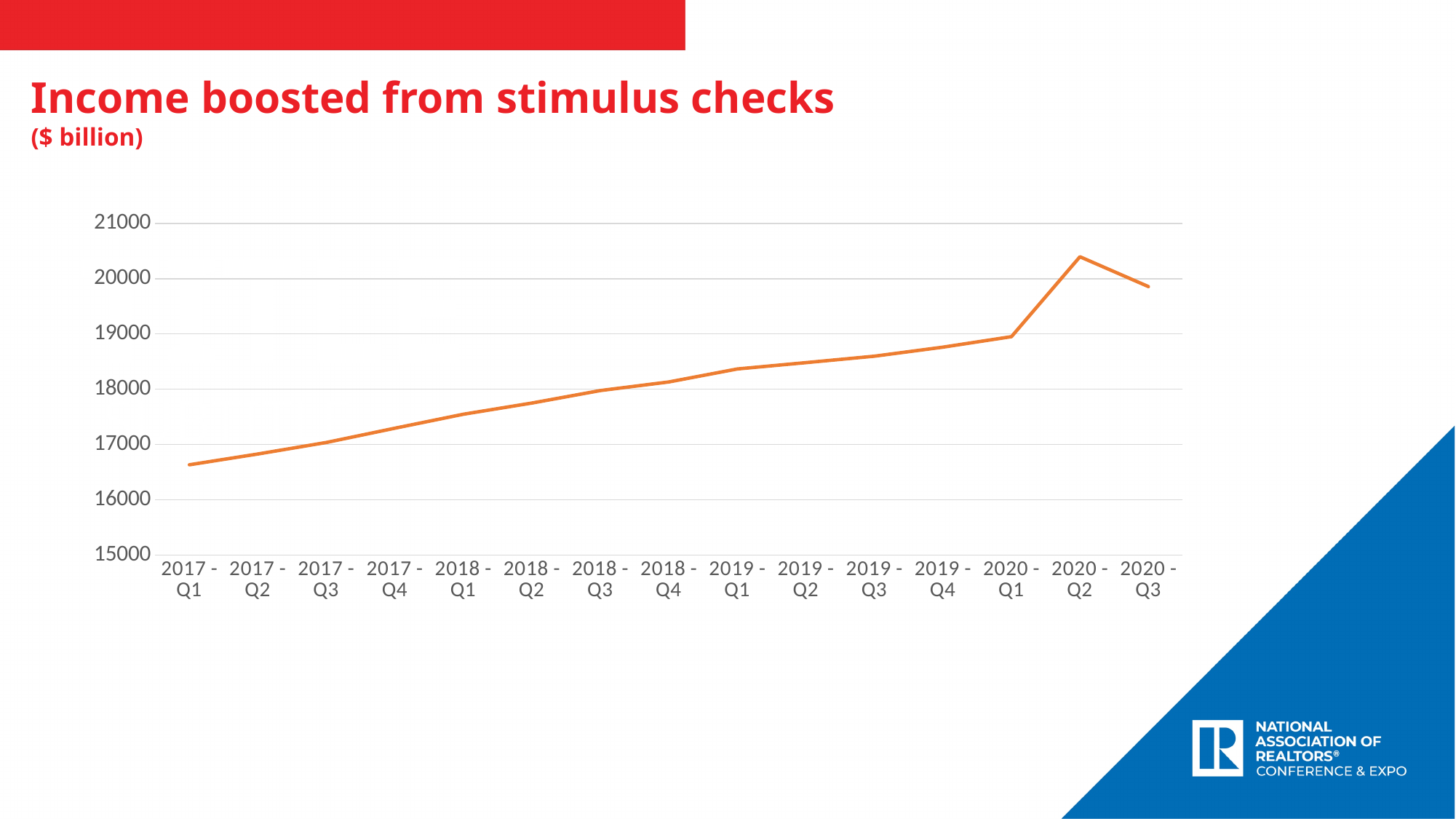
Is the value for 2017 - Q1 greater or less than 17000? less In what unit are the values on the chart expressed? $ billion What kind of chart is shown on the slide? Line chart Which quarter has the highest value? 2020 - Q2 Is the value for 2019 - Q1 greater or less than 18000? greater Which quarter has the lowest value? 2017 - Q1 Is the value for 2020 - Q3 greater or less than 20000? less How many quarters are plotted on the x axis? 15 Do the values generally rise or fall from 2017 - Q1 to 2020 - Q2? Rise What is the title of the chart? Income boosted from stimulus checks Which is larger, the value for 2020 - Q2 or the value for 2020 - Q3? 2020 - Q2